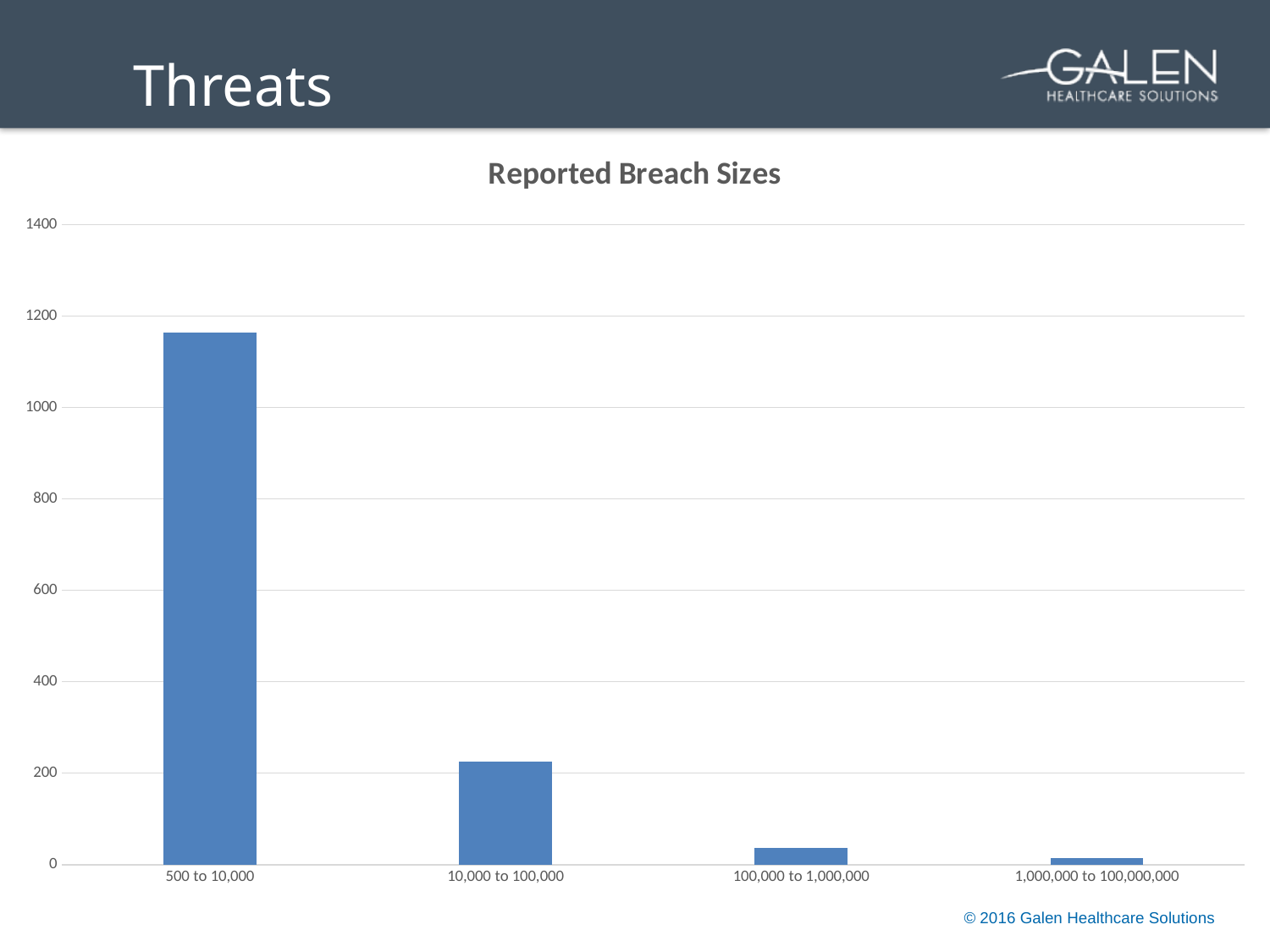
Is the value for 100,000 to 1,000,000 greater or less than 200? less Is the value for 10,000 to 100,000 greater or less than 200? greater What kind of chart is shown on the slide? bar chart How many categories are shown on the x axis of the chart? 4 What is the highest value shown on the y axis? 1400 Which is larger, the value for 10,000 to 100,000 or the value for 100,000 to 1,000,000? 10,000 to 100,000 Which category has the lowest value? 1,000,000 to 100,000,000 What is the title of the chart? Reported Breach Sizes Do the values rise or fall moving from left to right along the x axis? fall Is the value for 500 to 10,000 greater or less than 1200? less Which category has the highest value? 500 to 10,000